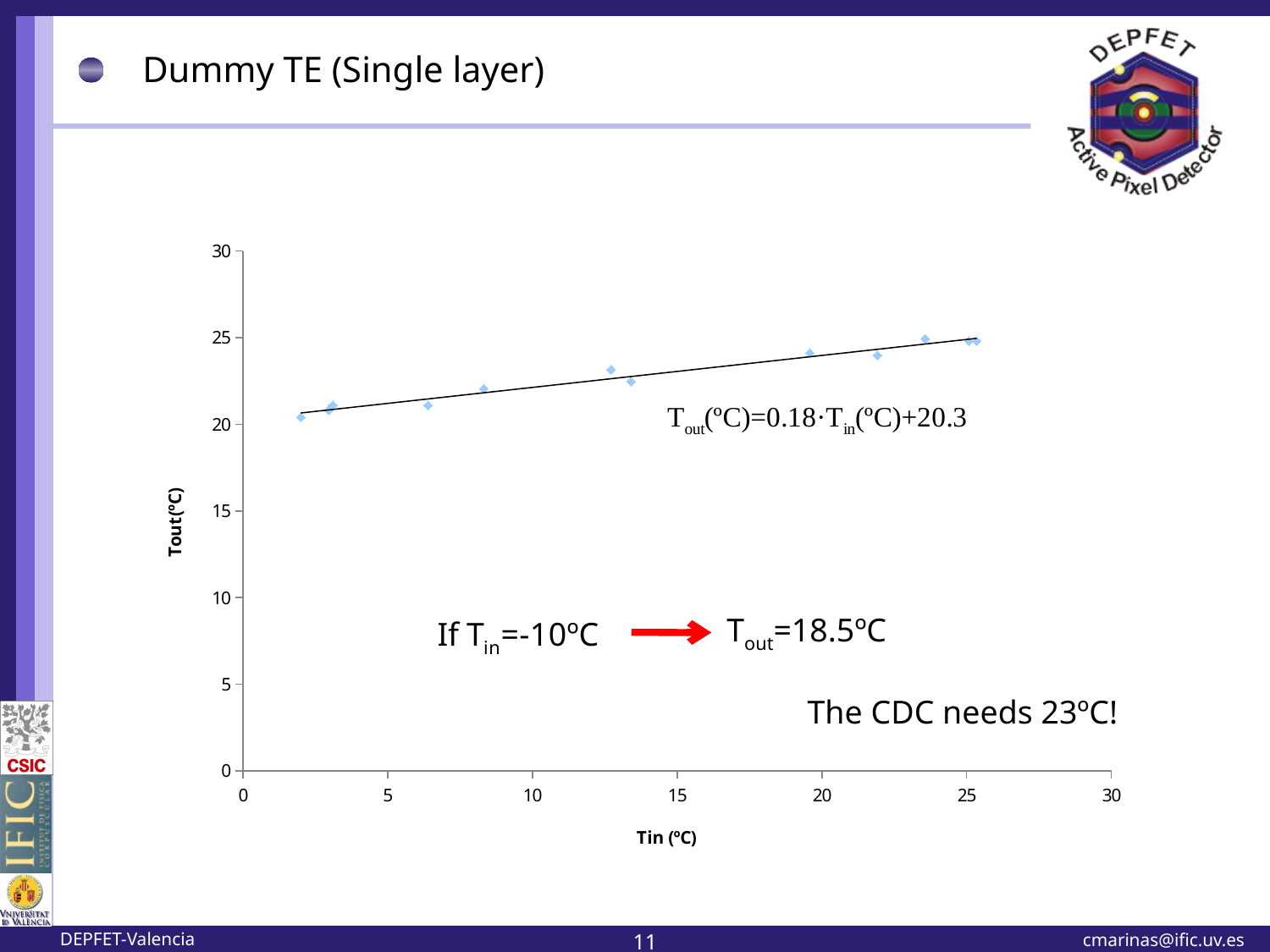
Is the Tout value of the data point at the highest Tin (around 25ºC) greater or less than 20? greater According to the fit equation printed on the chart, what is the intercept of Tout when Tin is 0? 20.3 Which data point has the higher Tout: the one near Tin = 2ºC or the one near Tin = 25ºC? the one near Tin = 25ºC What is the label of the y axis of the chart? Tout(ºC) Is the Tout value of the data point near Tin = 13ºC greater or less than 20? greater According to the slide, what is Tout when Tin = -10ºC? 18.5ºC What kind of chart is shown on the slide? scatter chart What is the label of the x axis of the chart? Tin (ºC) What is the maximum value shown on the x axis of the chart? 30 Is the Tout value of the data point at the lowest Tin (around 2ºC) greater or less than 25? less According to the fit equation printed on the chart, what is the slope of Tout versus Tin? 0.18 Do the Tout values rise or fall as Tin increases along the x axis? rise